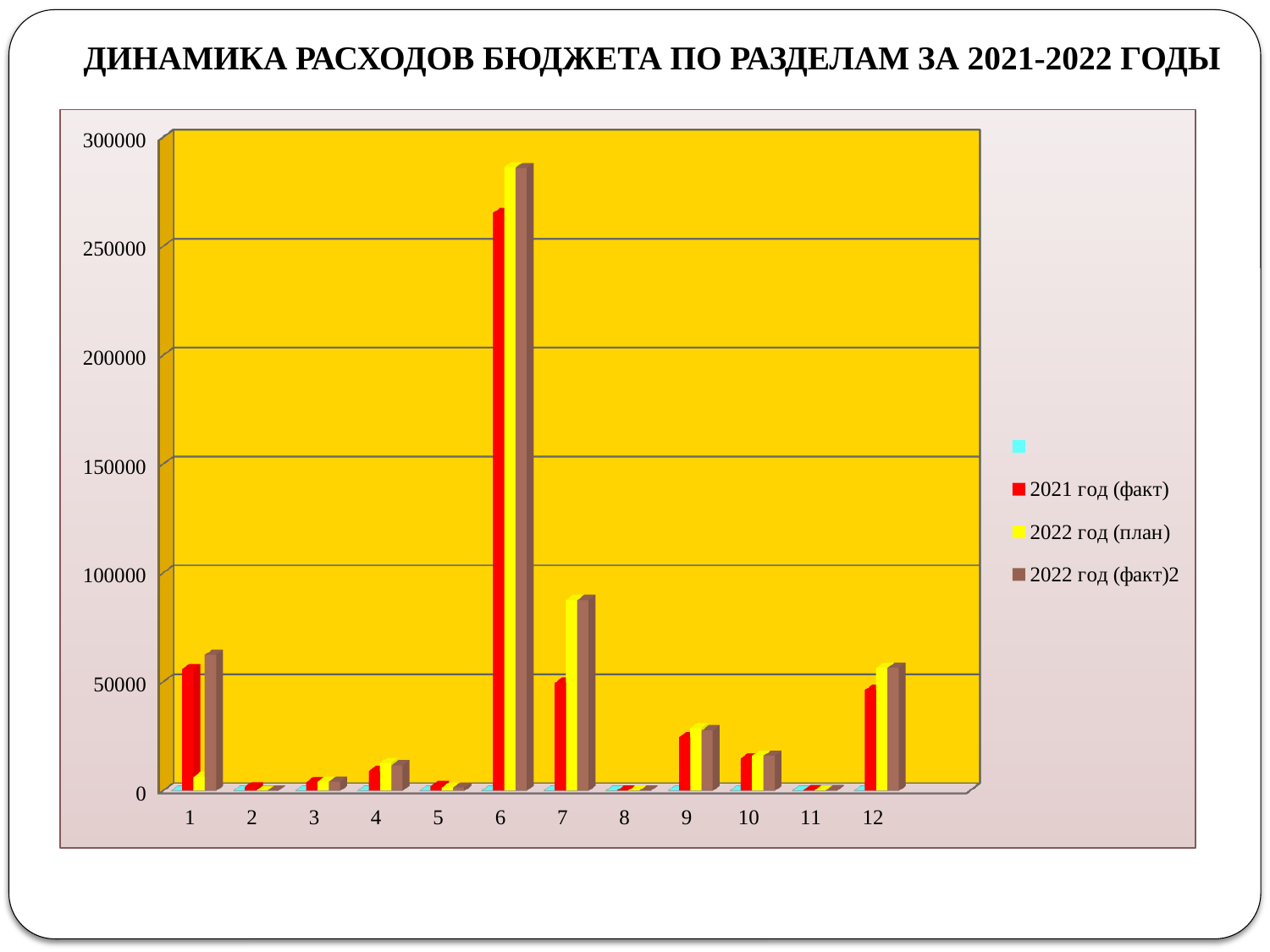
Is the value for category 7 in the series 2022 год (план) greater or less than 100000? less How many named series does the legend list? 3 Which category has the highest value for the series 2021 год (факт)? 6 Is the value for category 9 in the series 2022 год (факт)2 greater or less than 50000? less For category 7, which is larger: the value for 2021 год (факт) or for 2022 год (план)? 2022 год (план) Is the value for category 6 in the series 2021 год (факт) greater or less than 250000? greater Which category has the highest value for the series 2022 год (план)? 6 What is the title of the chart on the slide? ДИНАМИКА РАСХОДОВ БЮДЖЕТА ПО РАЗДЕЛАМ ЗА 2021-2022 ГОДЫ How many categories are shown on the x axis? 12 For the series 2021 год (факт), which is larger: the value for category 9 or for category 10? category 9 What kind of chart is shown on the slide? bar chart